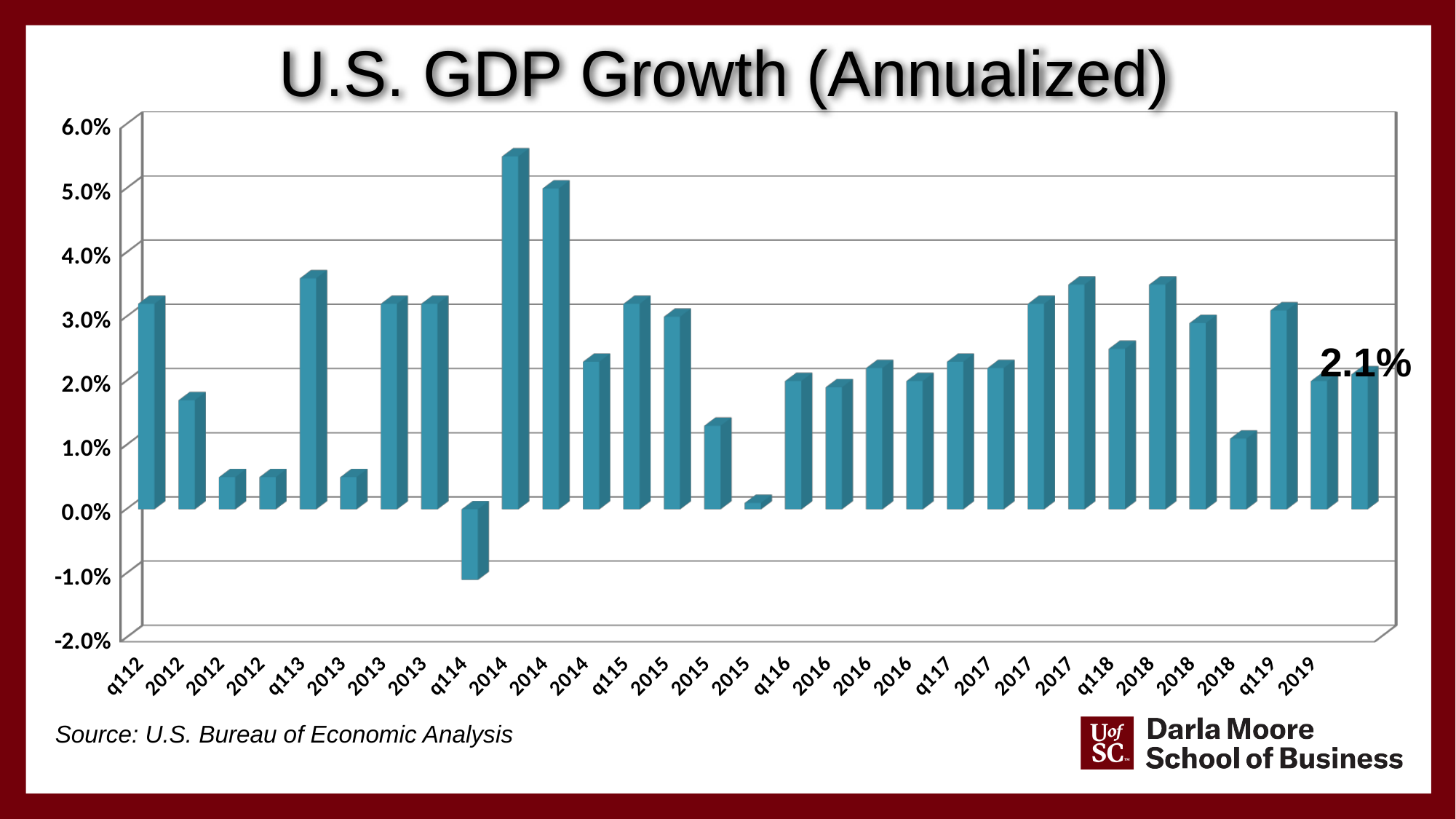
What kind of chart is shown on the slide? bar chart What source is cited for the chart data? U.S. Bureau of Economic Analysis In which year does the tallest bar on the chart occur? 2014 Is the value for q118 greater or less than 3.0%? less Is the value for q114 greater or less than 0.0%? less Is the value for q113 greater or less than 3.0%? greater What value is printed as the data label on the last bar of the chart? 2.1% Which has the larger value, q114 or q115? q115 What is the title of the chart? U.S. GDP Growth (Annualized) How many bars on the chart fall below 0.0%? 1 Which quarter has the lowest value on the chart? q114